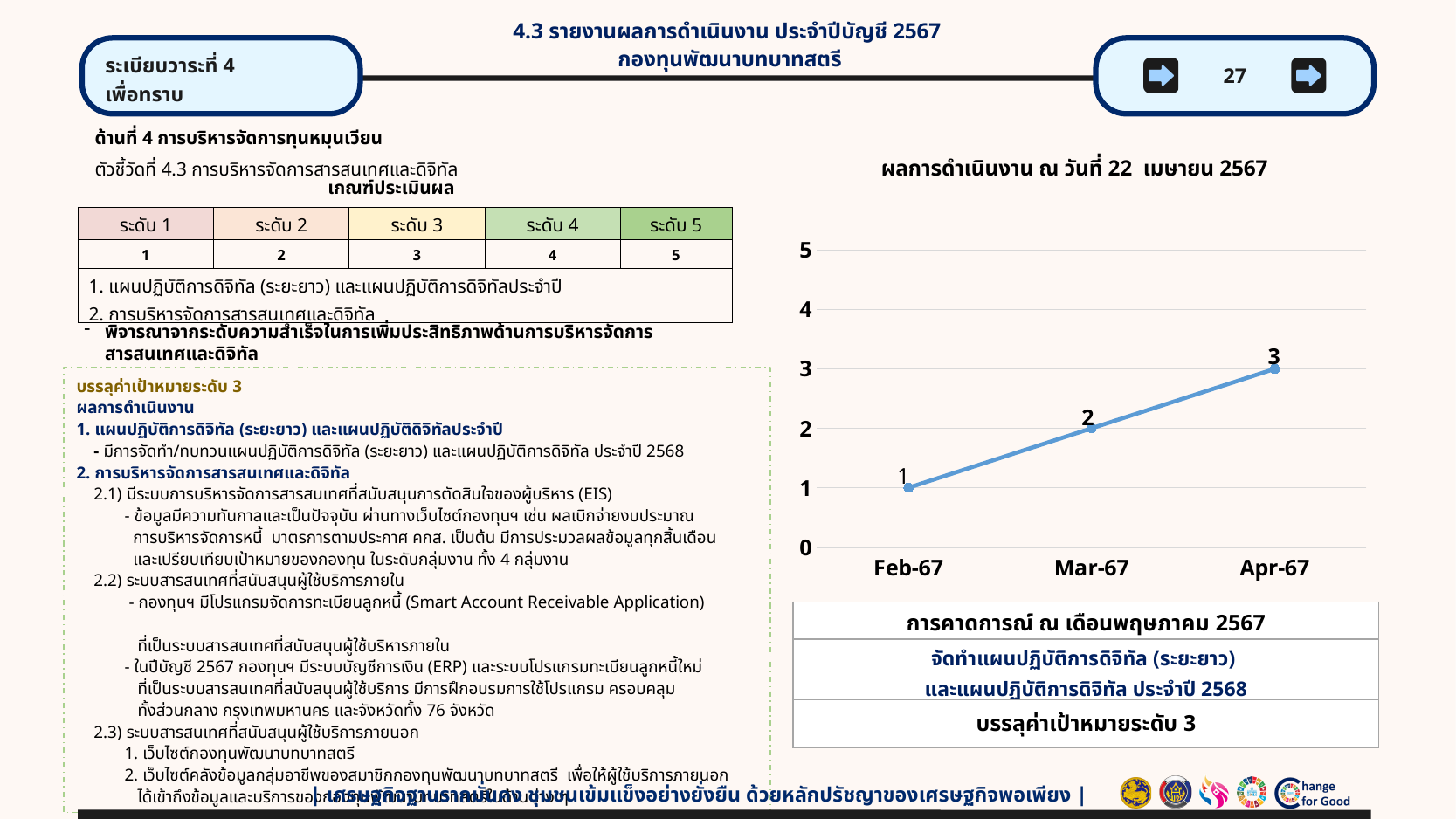
Which is larger, the value for Mar-67 or the value for Feb-67? Mar-67 What is the value for Mar-67? 2 What type of chart is shown on the slide? line chart Which month has the highest value? Apr-67 What is the difference between the values for Apr-67 and Feb-67? 2 Which month has the lowest value? Feb-67 What is the value for Feb-67? 1 What is the value for Apr-67? 3 Do the values rise or fall from Feb-67 to Apr-67? rise How many data points are plotted on the chart? 3 Is the value for Apr-67 greater or less than 4? less What is the maximum value shown on the y axis? 5